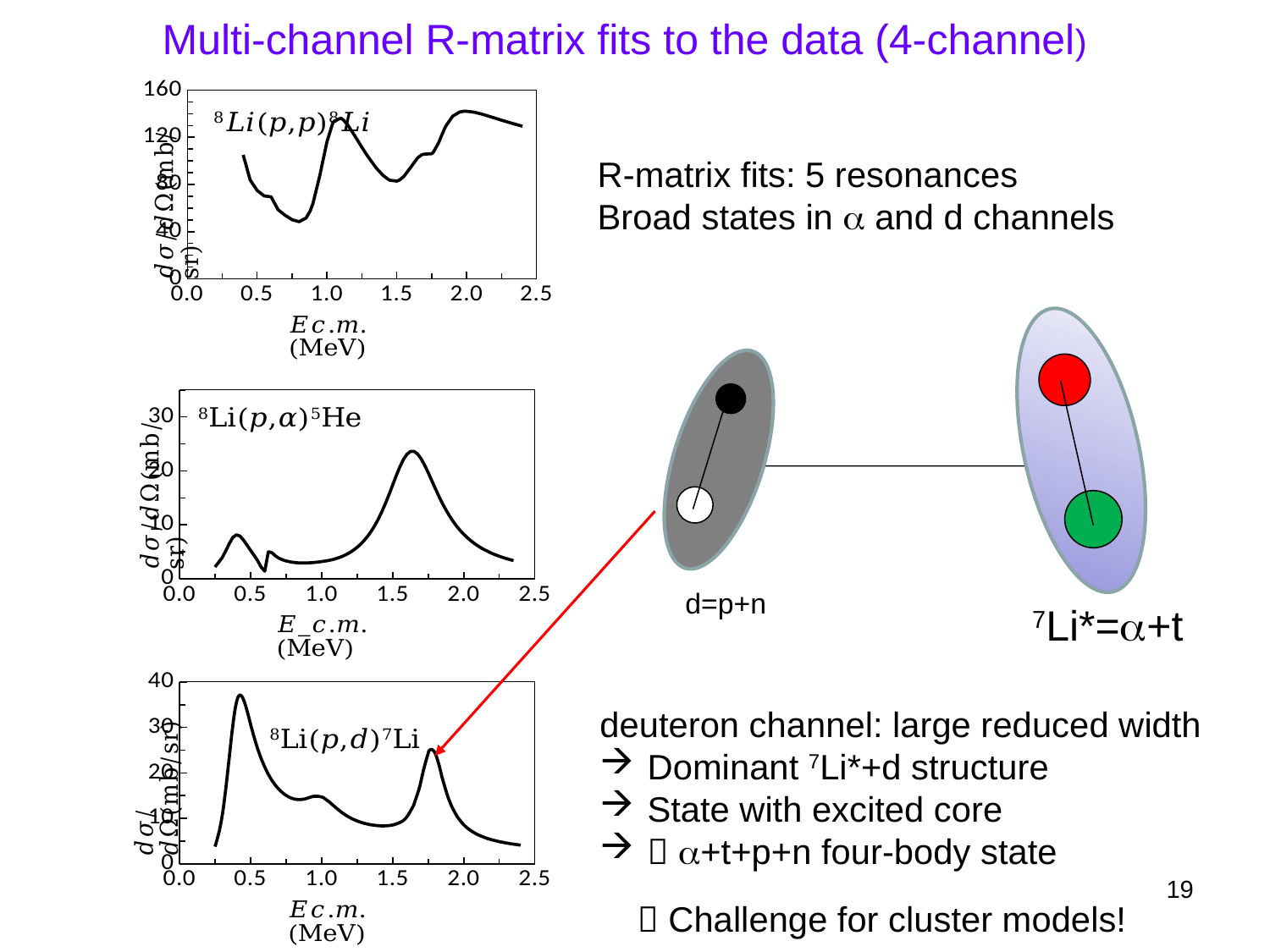
In the middle chart (8Li(p,α)5He), is the small peak near E c.m. = 0.4 MeV greater or less than 10? less In the bottom chart (8Li(p,d)7Li), which peak is higher: the one near 0.4 MeV or the one near 1.8 MeV? the one near 0.4 MeV What is the highest tick value on the x-axis of the bottom chart (8Li(p,d)7Li)? 2.5 In the top chart (8Li(p,p)8Li), is the value at E c.m. = 0.8 MeV greater or less than 80? less In the bottom chart (8Li(p,d)7Li), is the value at E c.m. = 2.4 MeV greater or less than 10? less What is the highest tick value on the y-axis of the top chart (8Li(p,p)8Li)? 160 What kind of chart is the top-left chart labelled 8Li(p,p)8Li? line chart How many charts are shown on the slide? 3